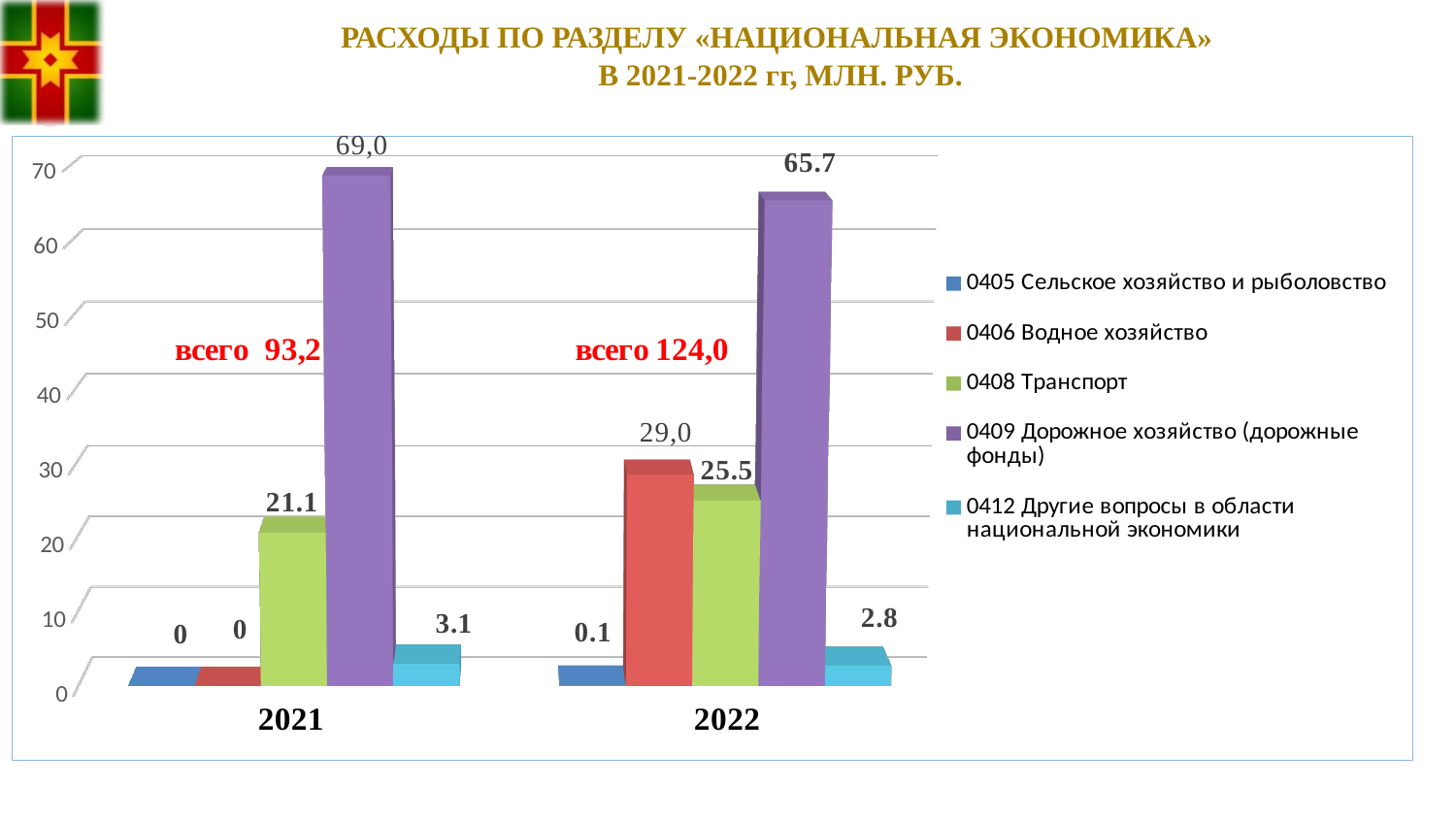
What total is shown for 2022 (всего)? 124,0 Which series has the highest value in 2022? 0409 Дорожное хозяйство (дорожные фонды) What is the value for 0408 Транспорт in 2022? 25.5 How many series does the legend list? 5 What is the difference between the 0409 Дорожное хозяйство values for 2021 and 2022? 3.3 How many year categories are shown on the x axis? 2 Which is larger: 0408 Транспорт in 2021 or 0408 Транспорт in 2022? 2022 What type of chart is shown on the slide? bar chart Does the value for 0409 Дорожное хозяйство (дорожные фонды) rise or fall from 2021 to 2022? fall What is the value for 0406 Водное хозяйство in 2022? 29,0 What is the value for 0412 Другие вопросы в области национальной экономики in 2021? 3.1 What is the value for 0409 Дорожное хозяйство (дорожные фонды) in 2021? 69,0